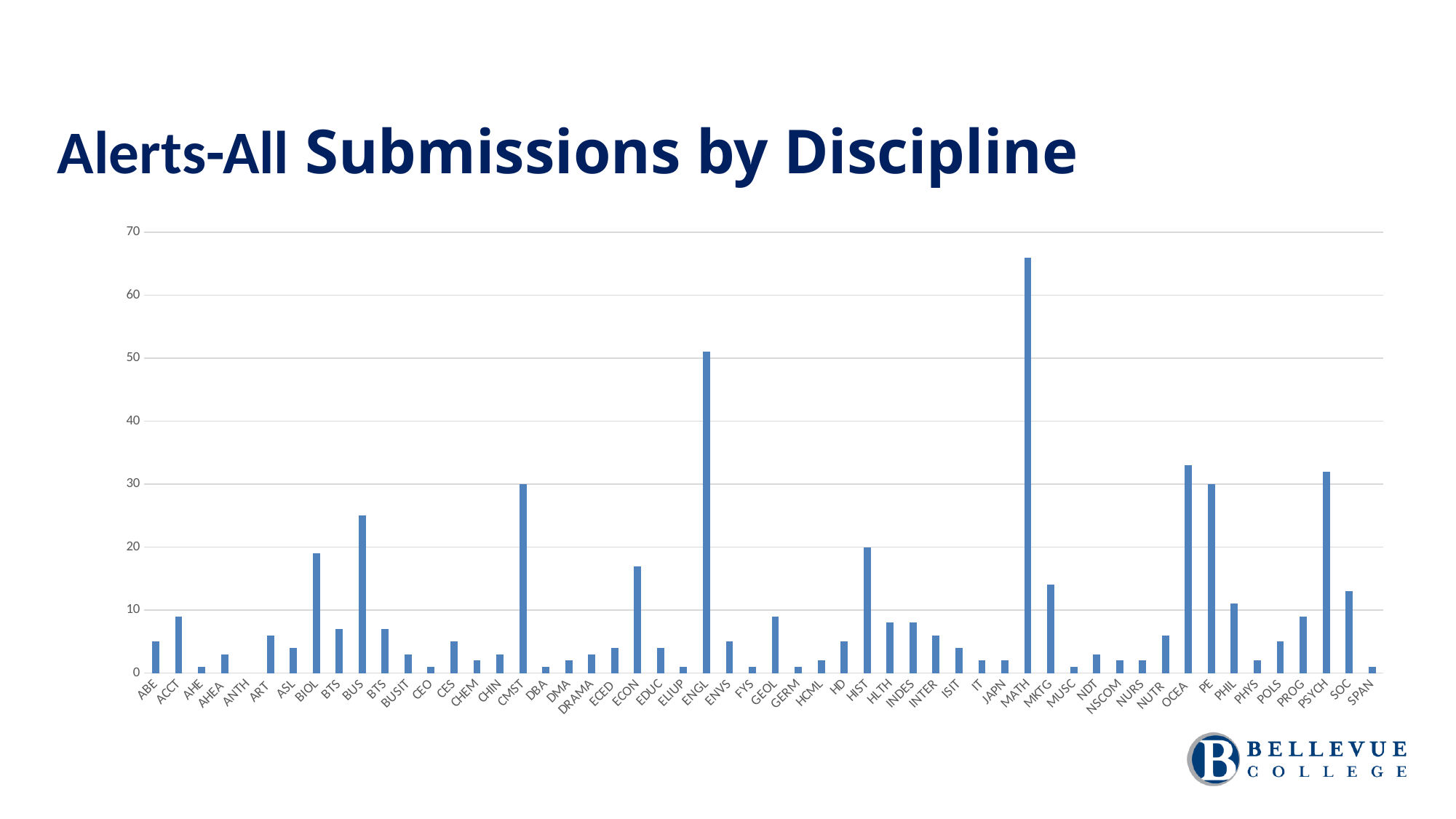
Which has more submissions, PSYCH or SOC? PSYCH What is the title of the chart? Alerts-All Submissions by Discipline Is the value for BUS greater or less than 20? greater How many disciplines are listed along the x axis? 54 Which discipline has the highest number of submissions? MATH Is the value for MATH greater or less than 60? greater Which has more submissions, ENGL or MATH? MATH What kind of chart is shown on the slide? bar chart Which has more submissions, BUS or BIOL? BUS